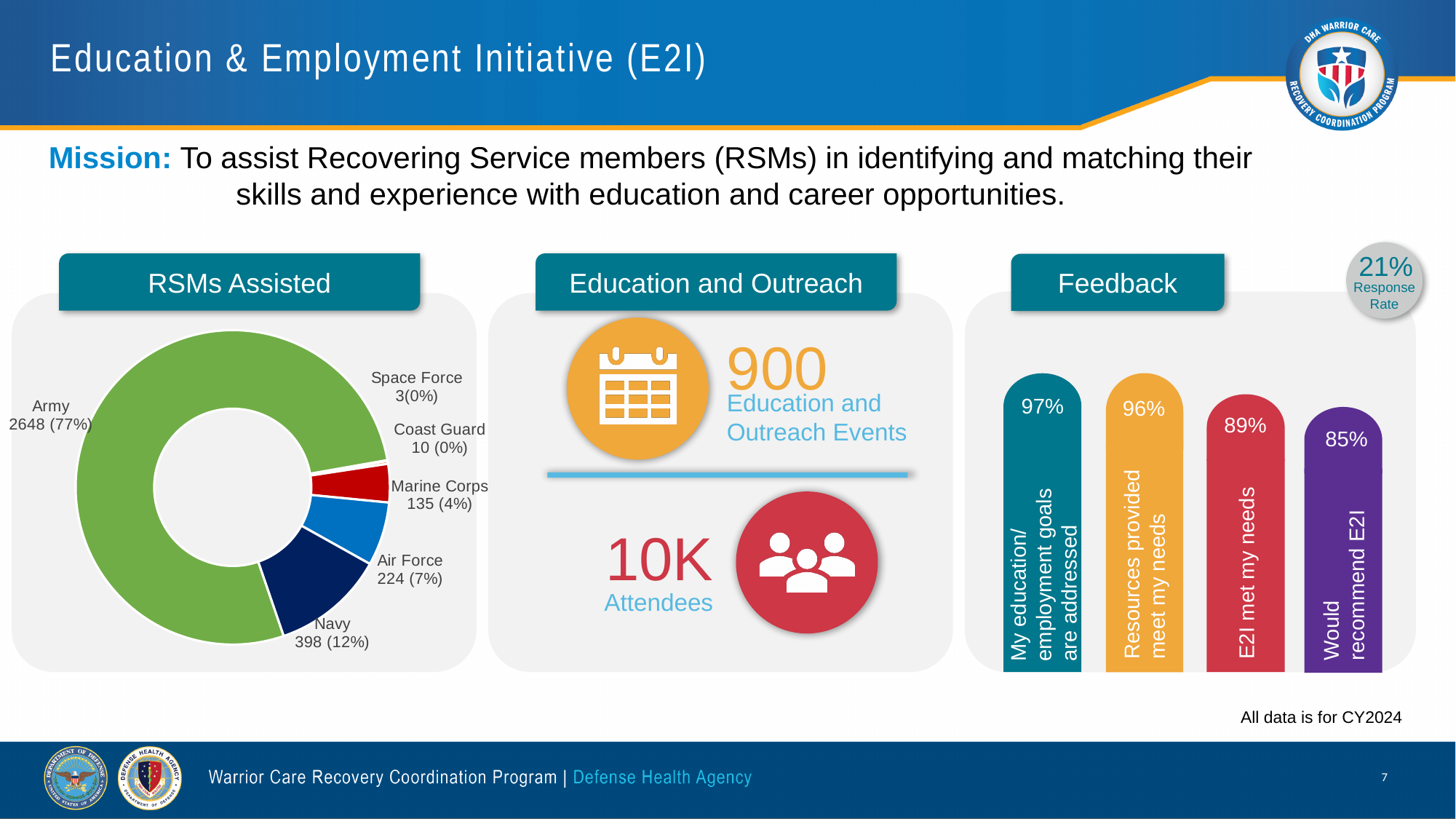
What kind of chart is the RSMs Assisted chart? Donut chart In the Feedback chart, which statement received the lowest percentage? Would recommend E2I In the RSMs Assisted chart, what share of RSMs assisted were from the Navy? 12% In the RSMs Assisted chart, what is the difference between the number of RSMs assisted from the Air Force and from the Marine Corps? 89 In the RSMs Assisted chart, which service branch has the largest number of RSMs assisted? Army How many bars are shown in the Feedback chart? 4 In the Feedback chart, what is the difference between the percentage for 'My education/employment goals are addressed' and 'Would recommend E2I'? 12% In the RSMs Assisted chart, which service branch has the smallest number of RSMs assisted? Space Force How many service branches are shown in the RSMs Assisted chart? 6 In the RSMs Assisted chart, which has more RSMs assisted, the Navy or the Air Force? Navy In the Feedback chart, what percentage of respondents said 'E2I met my needs'? 89% In the RSMs Assisted chart, how many RSMs were assisted from the Army? 2648